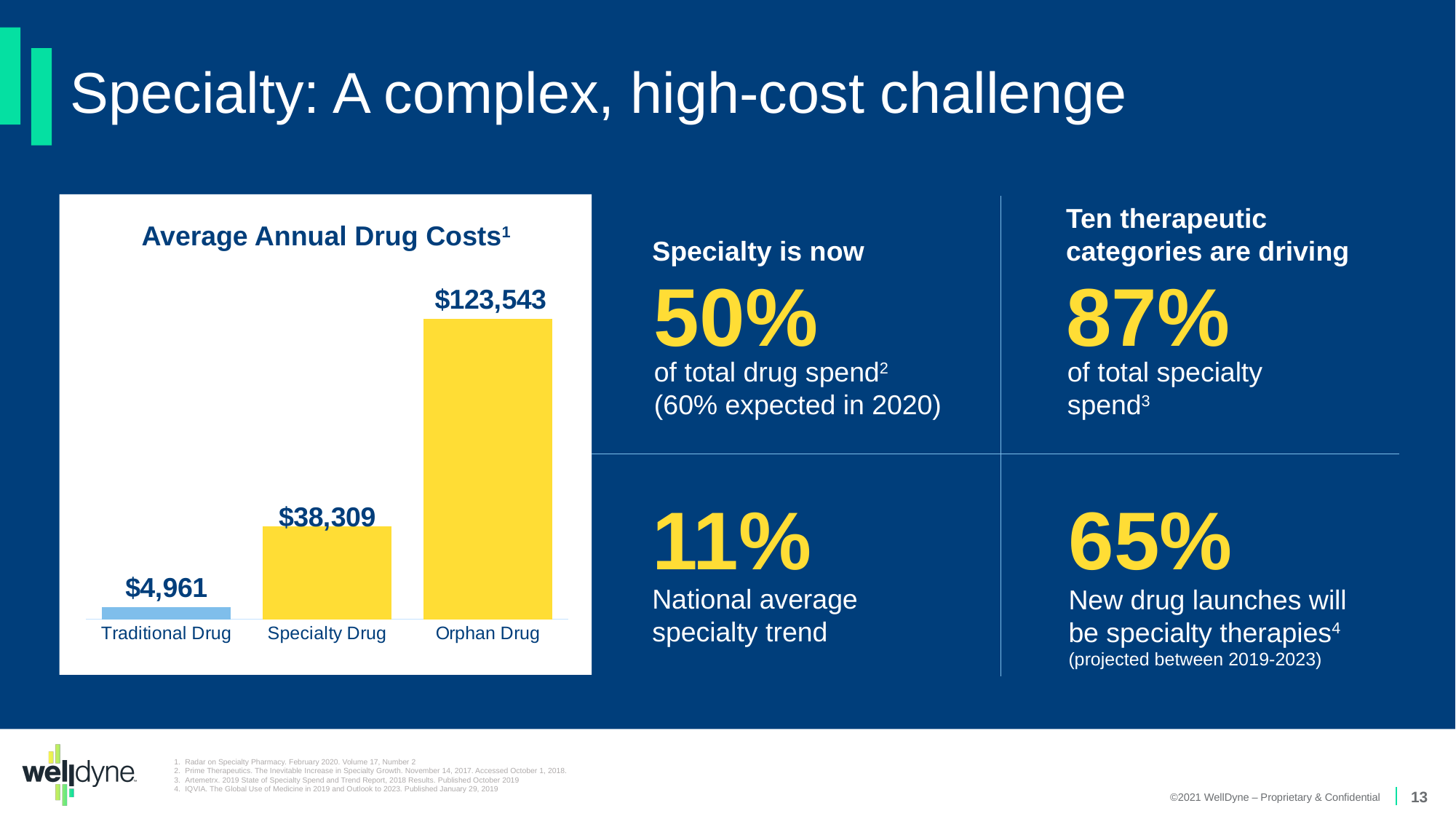
What is the average annual drug cost for a Specialty Drug? $38,309 Do the values rise or fall moving from Traditional Drug to Orphan Drug along the x axis? Rise How many drug categories are shown in the chart? 3 What type of chart is used to show Average Annual Drug Costs? Bar chart What is the average annual drug cost for a Traditional Drug? $4,961 What is the difference in average annual cost between an Orphan Drug and a Specialty Drug? $85,234 Which drug category has the highest average annual cost? Orphan Drug What is the difference in average annual cost between a Specialty Drug and a Traditional Drug? $33,348 Which drug category has the lowest average annual cost? Traditional Drug Which has a higher average annual cost, a Specialty Drug or a Traditional Drug? Specialty Drug What is the average annual drug cost for an Orphan Drug? $123,543 What is the title of the chart? Average Annual Drug Costs